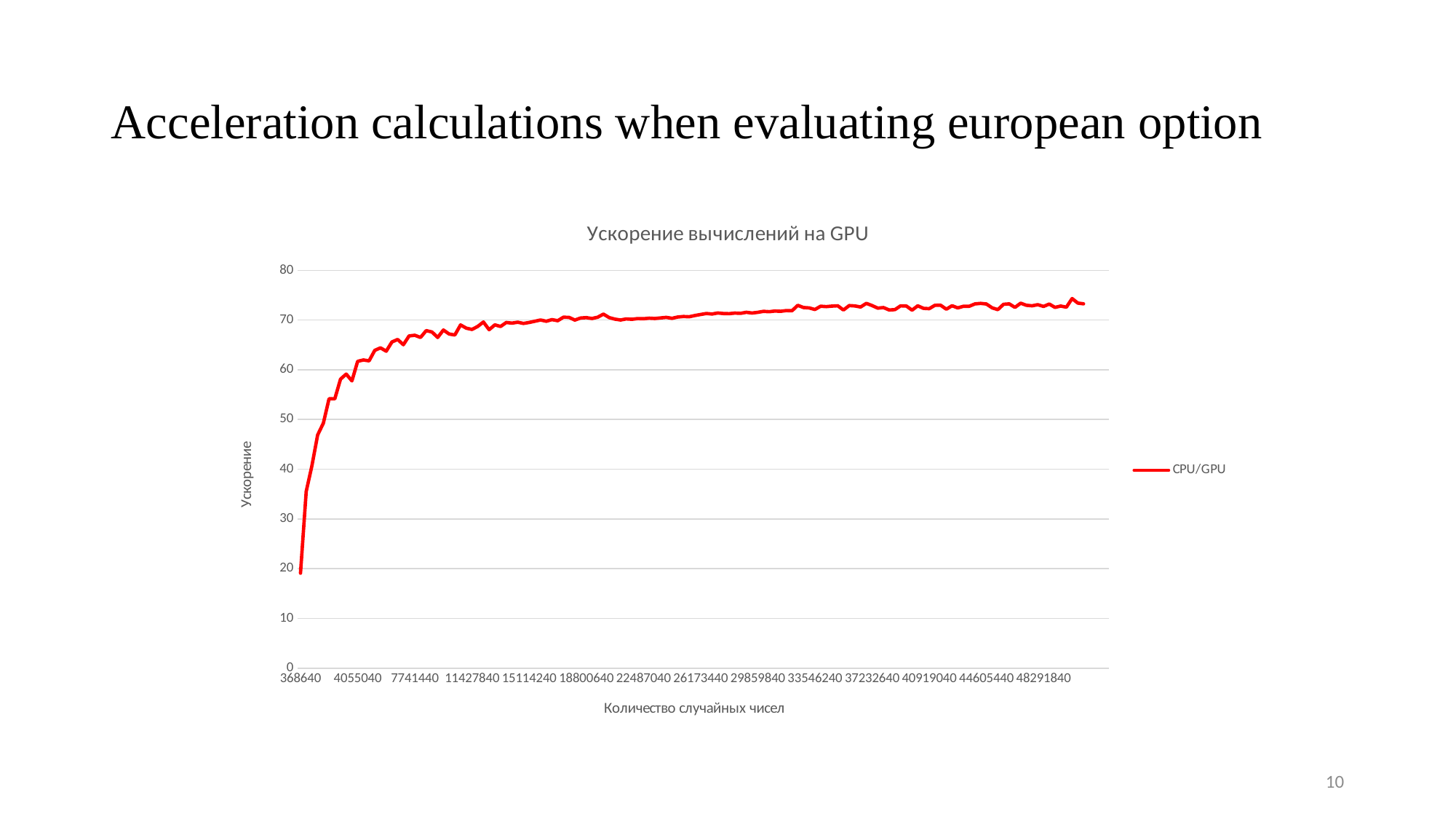
How many series does the legend list? 1 Is the CPU/GPU value at 368640 greater or less than 30? less Is the CPU/GPU value at 7741440 greater or less than 60? greater Which has the larger CPU/GPU value, 4055040 or 18800640 random numbers? 18800640 Is the CPU/GPU value at 48291840 greater or less than 70? greater What is the name of the series shown in the legend? CPU/GPU Which has the larger CPU/GPU value, 368640 or 48291840 random numbers? 48291840 What kind of chart is shown on the slide? line chart What is the title of the chart? Ускорение вычислений на GPU Do the CPU/GPU values generally rise or fall as the number of random numbers increases along the x axis? rise